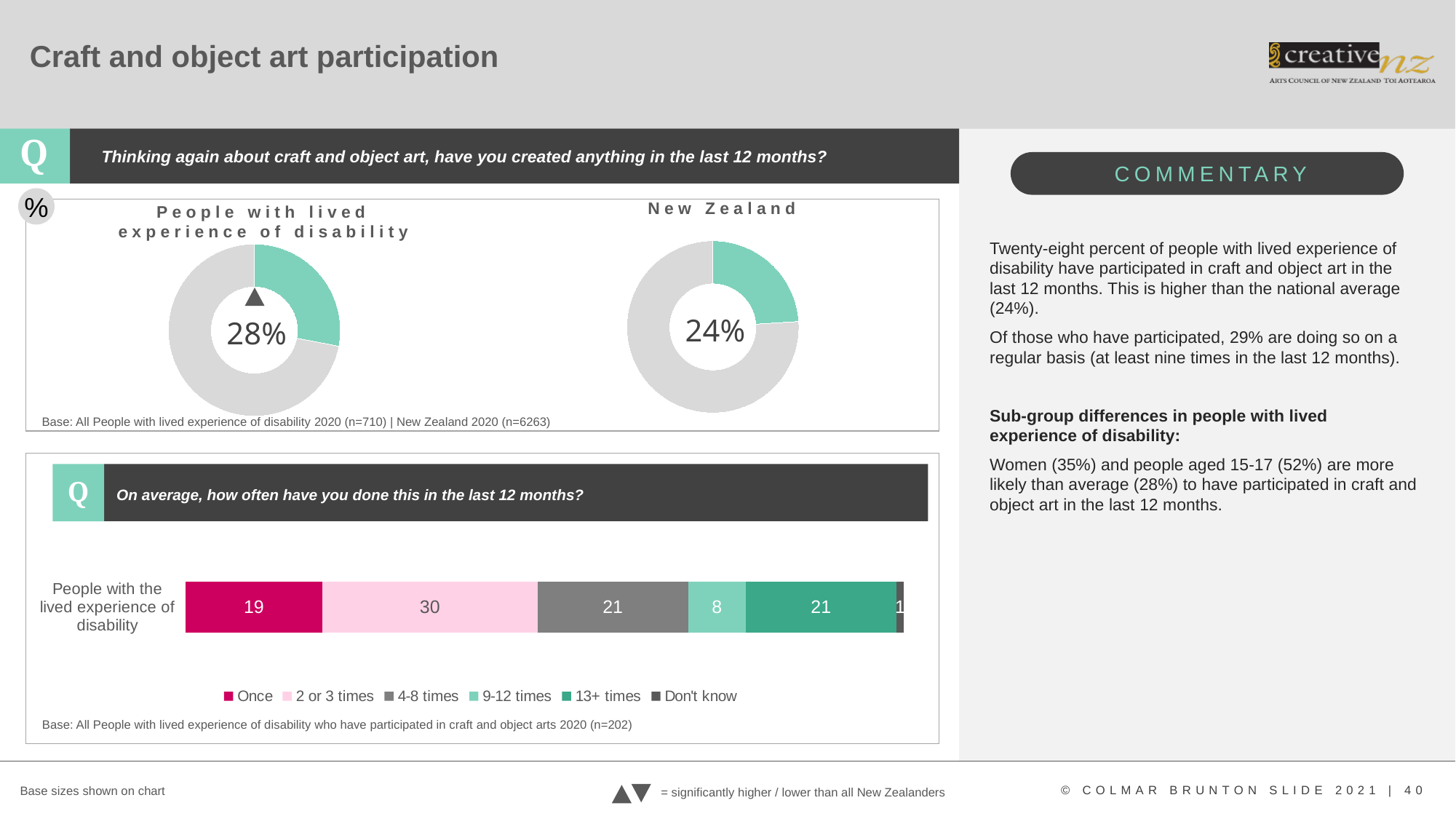
In the stacked bar chart about how often people have done this in the last 12 months, is the value for '4-8 times' larger or smaller than the value for '9-12 times'? Larger In the stacked bar chart about how often people have done this in the last 12 months, what is the value for '9-12 times'? 8 In the stacked bar chart about how often people have done this in the last 12 months, which frequency category has the largest value? 2 or 3 times In the stacked bar chart about how often people have done this in the last 12 months, what is the difference between the '2 or 3 times' value and the 'Once' value? 11 In the stacked bar chart about how often people have done this in the last 12 months, what is the value for '2 or 3 times'? 30 In the donut chart titled 'New Zealand', what percentage is shown in the centre? 24% Comparing the two donut charts, which group has the higher participation percentage: people with lived experience of disability or New Zealand? People with lived experience of disability In the donut chart titled 'People with lived experience of disability', what percentage is shown in the centre? 28% What type of chart is used to show how often people have done this in the last 12 months? Stacked bar chart In the stacked bar chart about how often people have done this in the last 12 months, how many series does the legend list? 6 In the stacked bar chart about how often people have done this in the last 12 months, what is the value for 'Once'? 19 What is the difference in percentage points between the 'People with lived experience of disability' donut (28%) and the 'New Zealand' donut (24%)? 4 percentage points